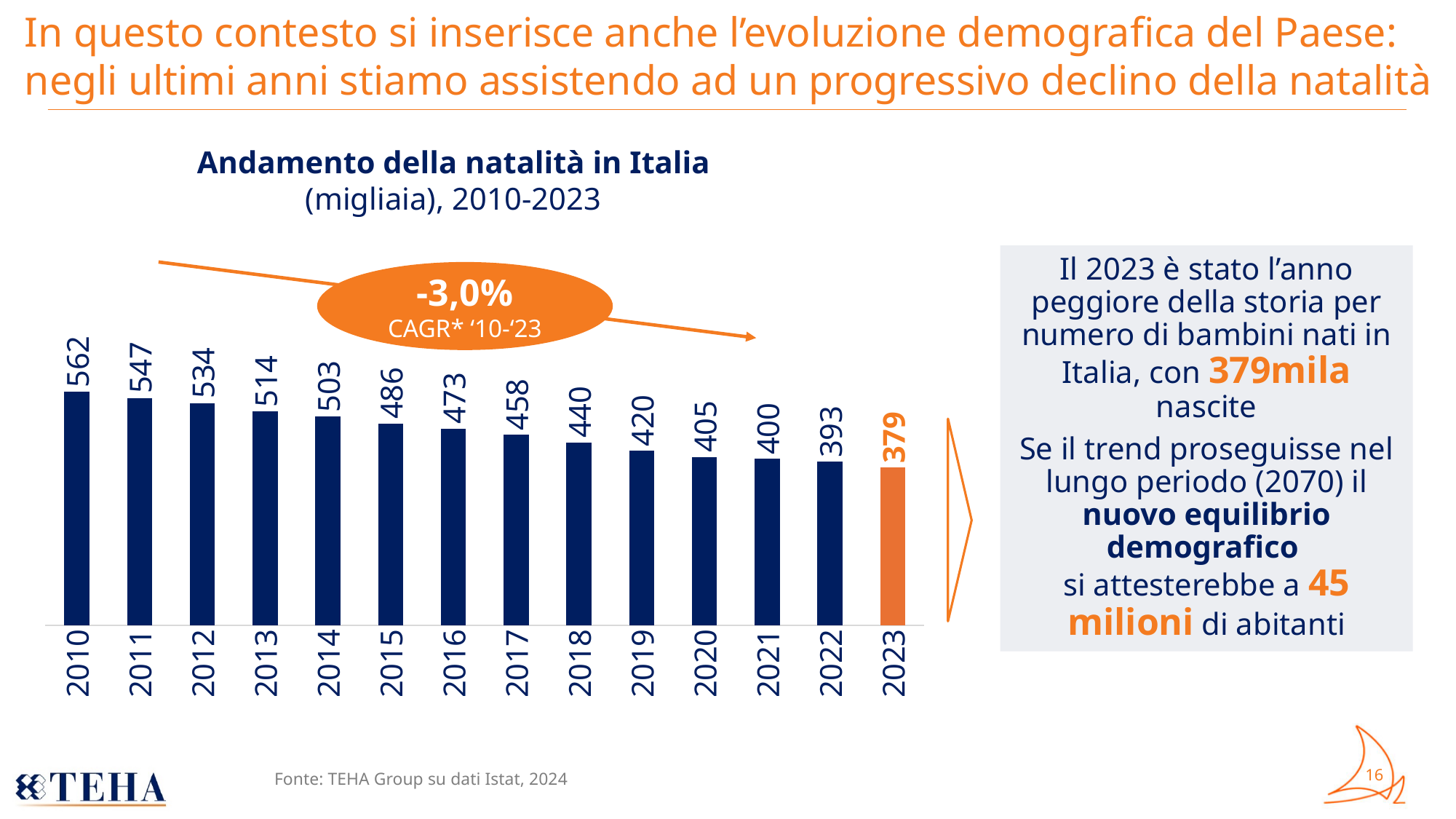
What is the value for 2010? 562 What kind of chart is this? Bar chart Do the values rise or fall from 2010 to 2023? Fall Which is larger, the value for 2013 or the value for 2018? 2013 What is the difference between the values for 2010 and 2023? 183 Which year has the highest value? 2010 What is the value for 2023? 379 What is the value for 2016? 473 What is the difference between the values for 2021 and 2022? 7 Which year has the lowest value? 2023 What CAGR for 2010-2023 is shown on the chart? -3,0% How many years are shown on the x axis? 14